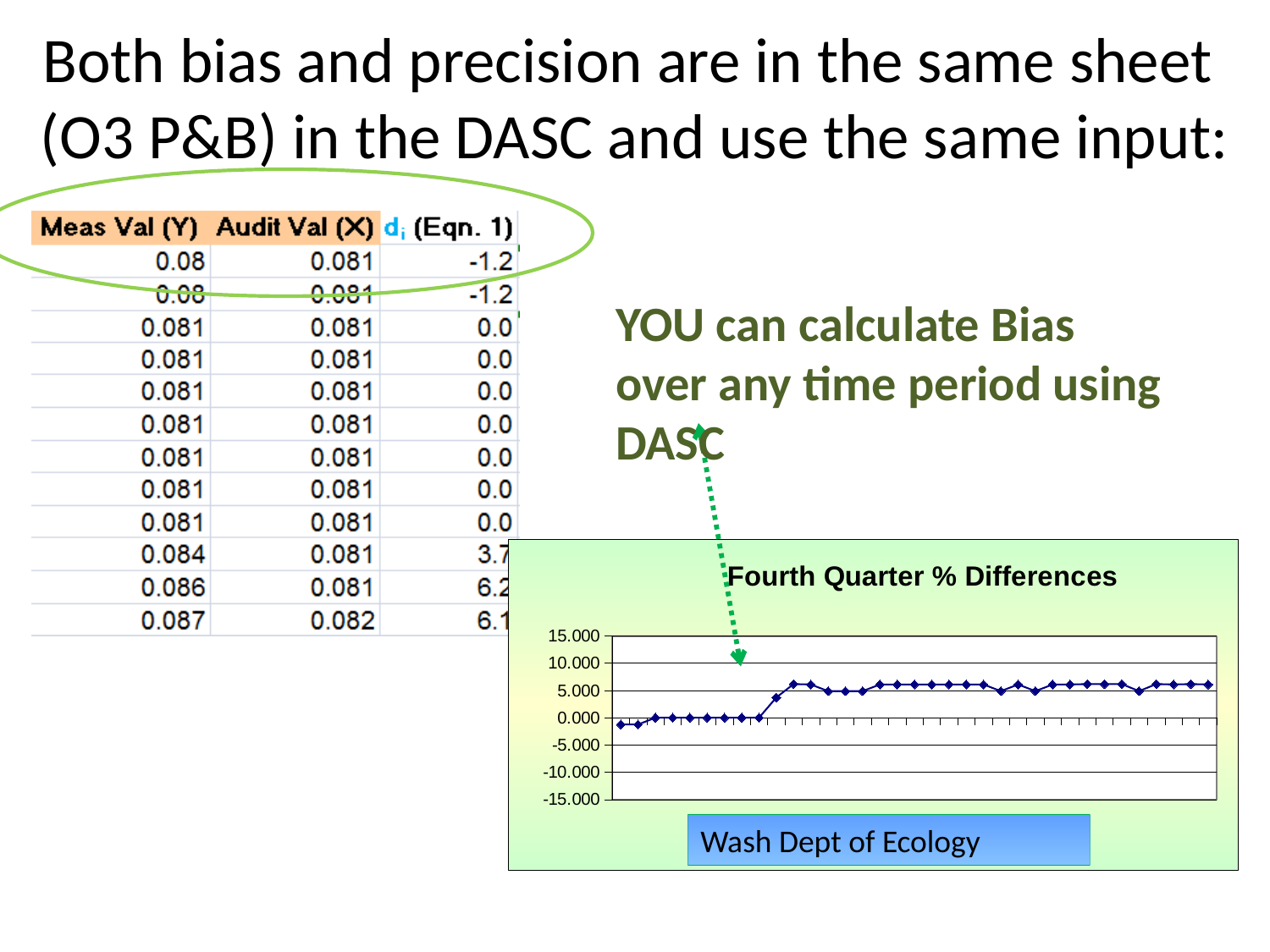
In the "Fourth Quarter % Differences" chart, is the highest plotted value greater or less than 10.000? less In the "Fourth Quarter % Differences" chart, is the last plotted point higher or lower than the first plotted point? higher In the "Fourth Quarter % Differences" chart, do the plotted values rise or fall from the start to the end of the x axis? rise In the "Fourth Quarter % Differences" chart, is the first plotted value greater or less than 5.000? less In the "Fourth Quarter % Differences" chart, is the last plotted value greater or less than 0.000? greater What kind of chart is "Fourth Quarter % Differences"? line chart What is the highest tick value shown on the y axis of the "Fourth Quarter % Differences" chart? 15.000 What is the title of the chart on the slide? Fourth Quarter % Differences